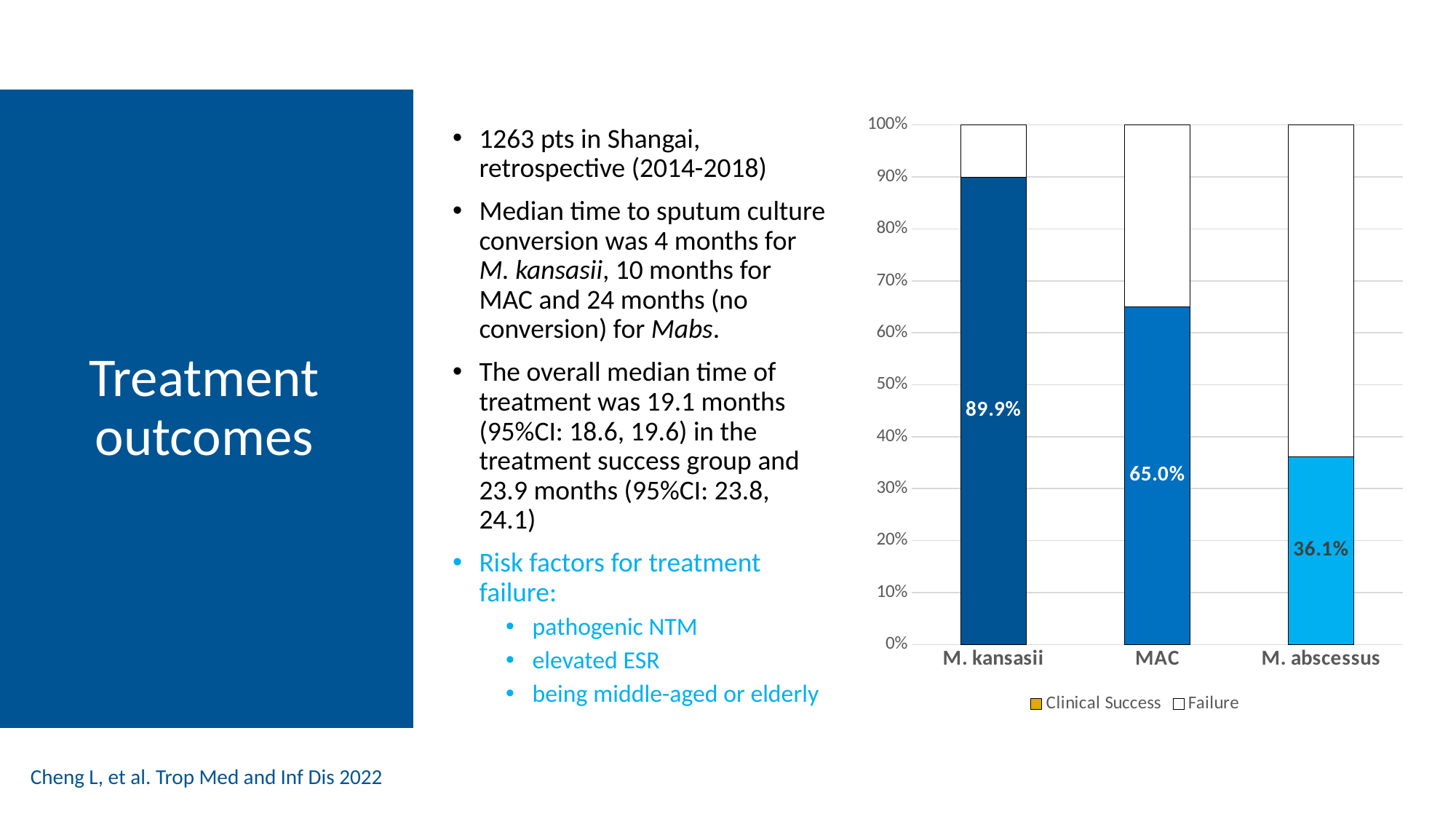
How many categories are shown on the x axis? 3 Which category has the highest Clinical Success value? M. kansasii What is the Clinical Success value for M. abscessus? 36.1% Is the Failure share for M. abscessus greater or less than 50%? greater What is the Clinical Success value for M. kansasii? 89.9% Which has a larger Clinical Success value, MAC or M. abscessus? MAC What kind of chart is shown on the slide? Stacked bar chart Which category has the lowest Clinical Success value? M. abscessus What is the Clinical Success value for MAC? 65.0% What is the difference between the Clinical Success values for MAC and M. abscessus? 28.9% What is the difference between the Clinical Success values for M. kansasii and MAC? 24.9% How many series does the legend list? 2